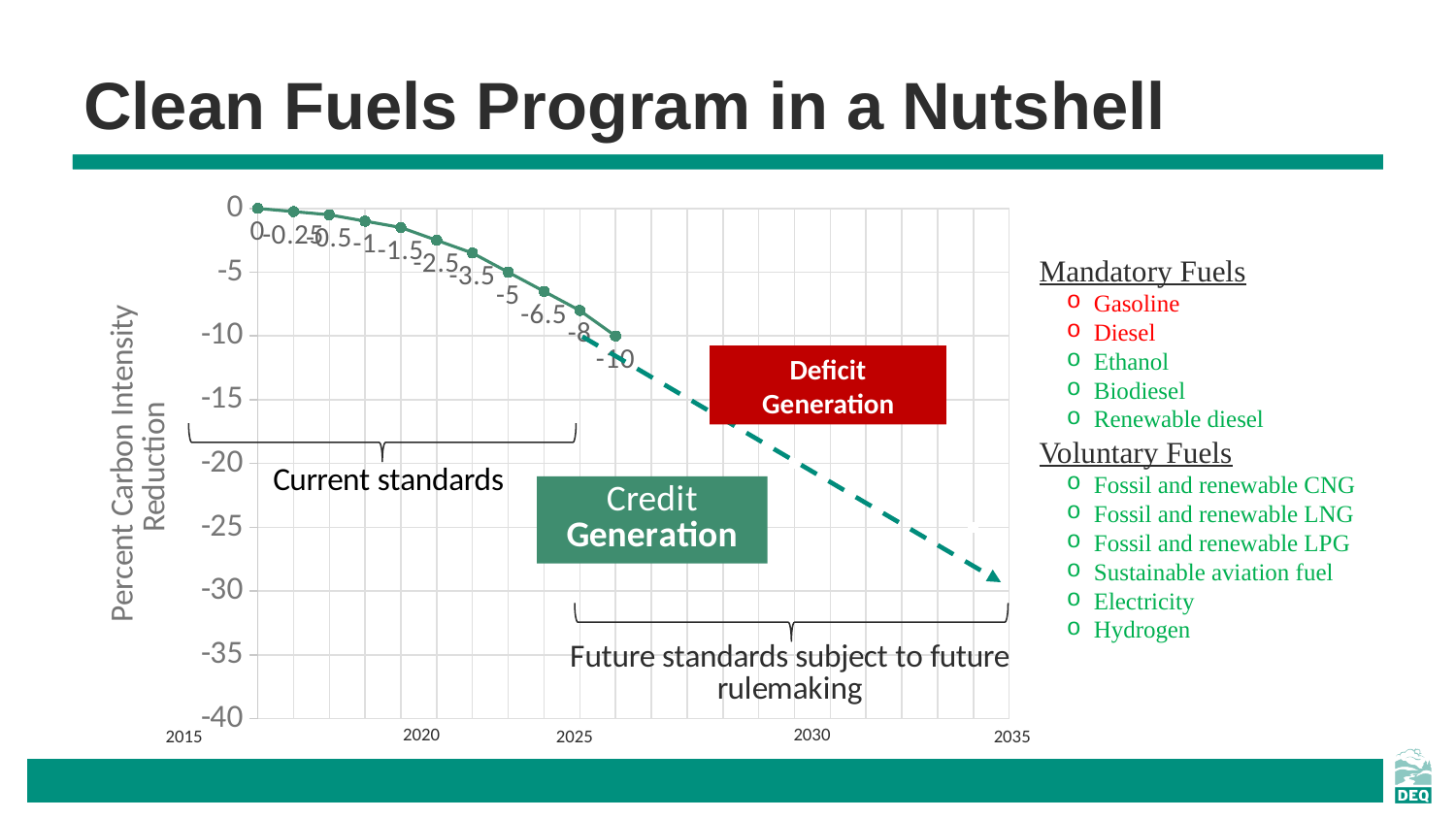
What is the title of the vertical axis of the chart? Percent Carbon Intensity Reduction What is the lowest data label printed on the solid line of the chart? -10 Do the plotted values rise or fall as the years increase along the x axis? fall Which data label on the solid line is larger, -6.5 or -8? -6.5 Is the value at the end of the dashed line in 2035 greater or less than -35? greater What is the difference between the data labels -5 and -10 on the chart? 5 Is the value at the end of the dashed line in 2035 greater or less than -20? less What is the difference between the data labels -8 and -10 on the chart? 2 What is the first year label shown on the x axis of the chart? 2015 How many data labels are printed along the solid line of the chart? 11 What kind of chart is shown on the slide? line chart What is the highest data label printed on the solid line of the chart? 0